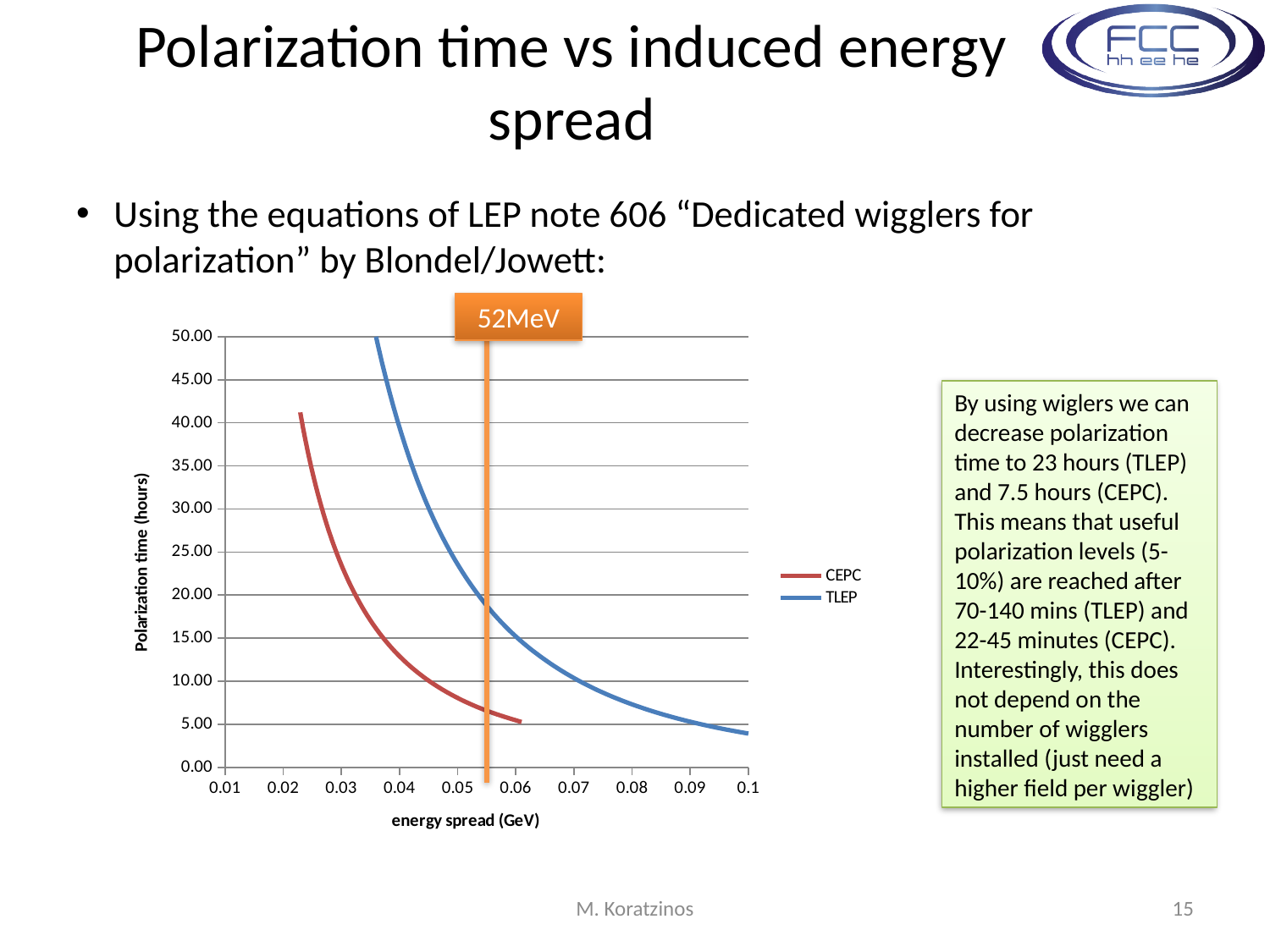
What kind of chart is shown on the slide? line chart Does the polarization time for TLEP rise or fall as energy spread increases? fall What are the two series named in the chart legend? CEPC and TLEP Is the CEPC polarization time at an energy spread of 0.04 GeV greater or less than 15.00 hours? less Is the CEPC polarization time at an energy spread of 0.06 GeV greater or less than 10.00 hours? less At an energy spread of 0.05 GeV, which series has the larger polarization time, CEPC or TLEP? TLEP Does the polarization time for CEPC rise or fall as energy spread increases? fall What is the title of the chart's vertical axis? Polarization time (hours) Is the TLEP polarization time at an energy spread of 0.08 GeV greater or less than 10.00 hours? less How many series does the chart legend list? 2